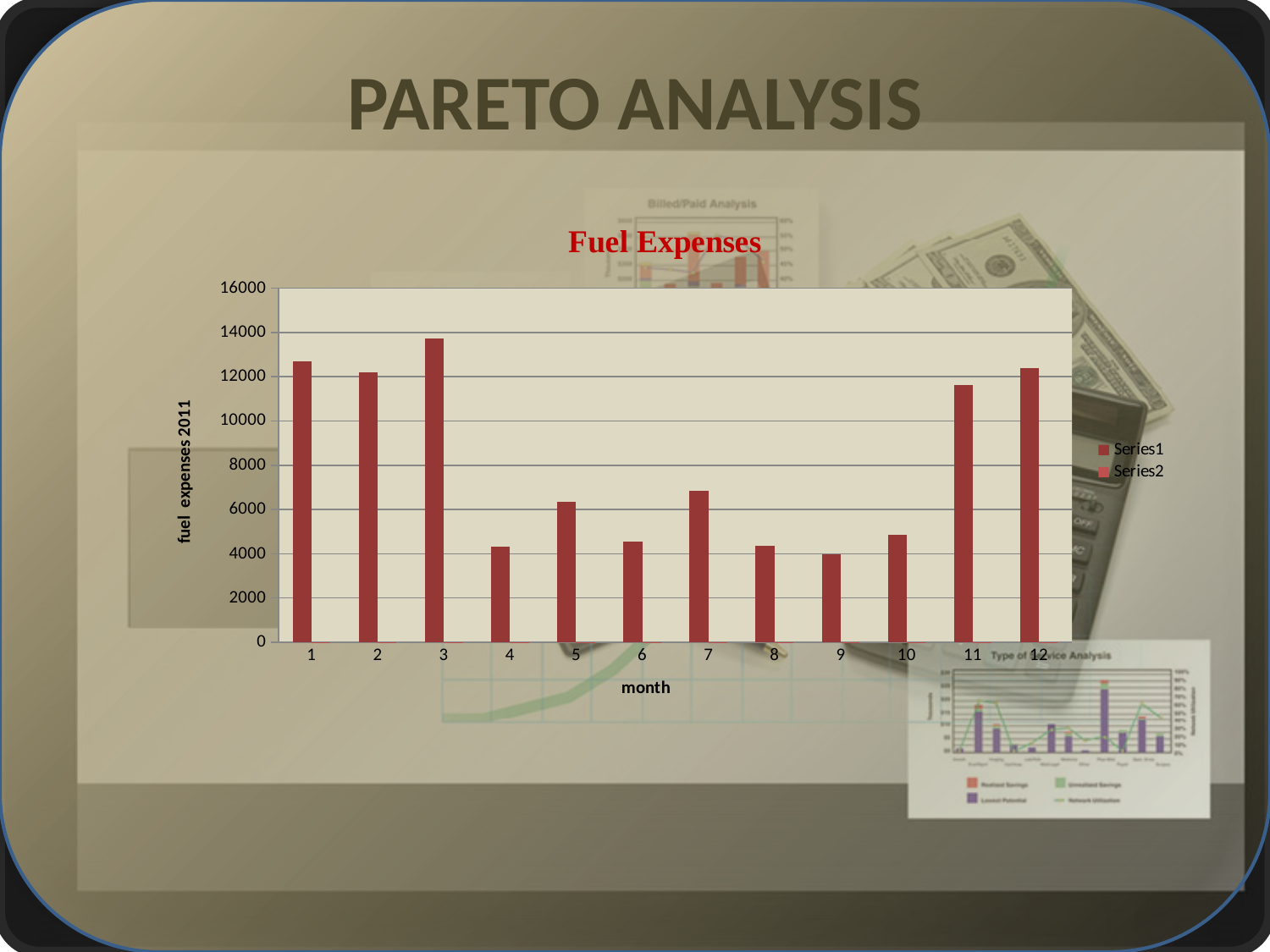
Do the values rise or fall from month 9 to month 12? rise What is the label on the x axis of the Fuel Expenses chart? month Which is larger, the value for month 1 or the value for month 11? month 1 Is the value for month 11 greater or less than 10000? greater Is the value for month 4 greater or less than 6000? less Which is larger, the value for month 7 or the value for month 8? month 7 Which month has the highest fuel expenses in the chart? 3 How many series does the legend of the Fuel Expenses chart list? 2 How many months are shown on the x axis of the Fuel Expenses chart? 12 Is the value for month 10 greater or less than 6000? less What type of chart is used to show Fuel Expenses? bar chart